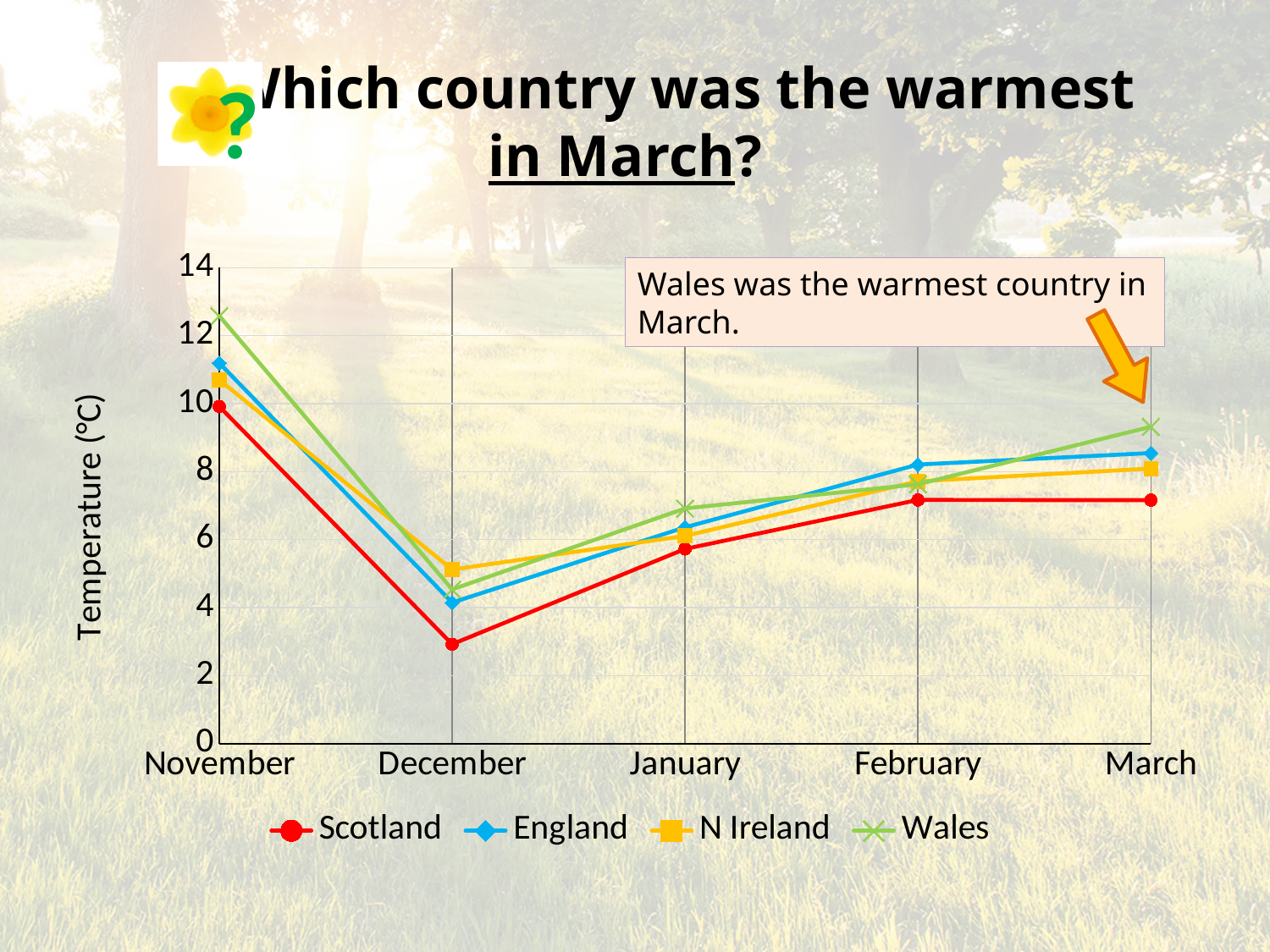
Is the value for Scotland in December greater or less than 4? less Do the temperatures for Scotland rise or fall from December to February? rise Which country has the lowest temperature in December? Scotland Which country has the lowest temperature in March? Scotland What is the title of the vertical axis? Temperature (°C) What kind of chart is shown on the slide? line chart How many months are shown along the x axis? 5 Is the value for Wales in November greater or less than 12? greater Which country has the highest temperature in March? Wales Which is larger, the temperature for England in March or the temperature for Scotland in March? England Which country has the highest temperature in November? Wales How many series does the legend list? 4